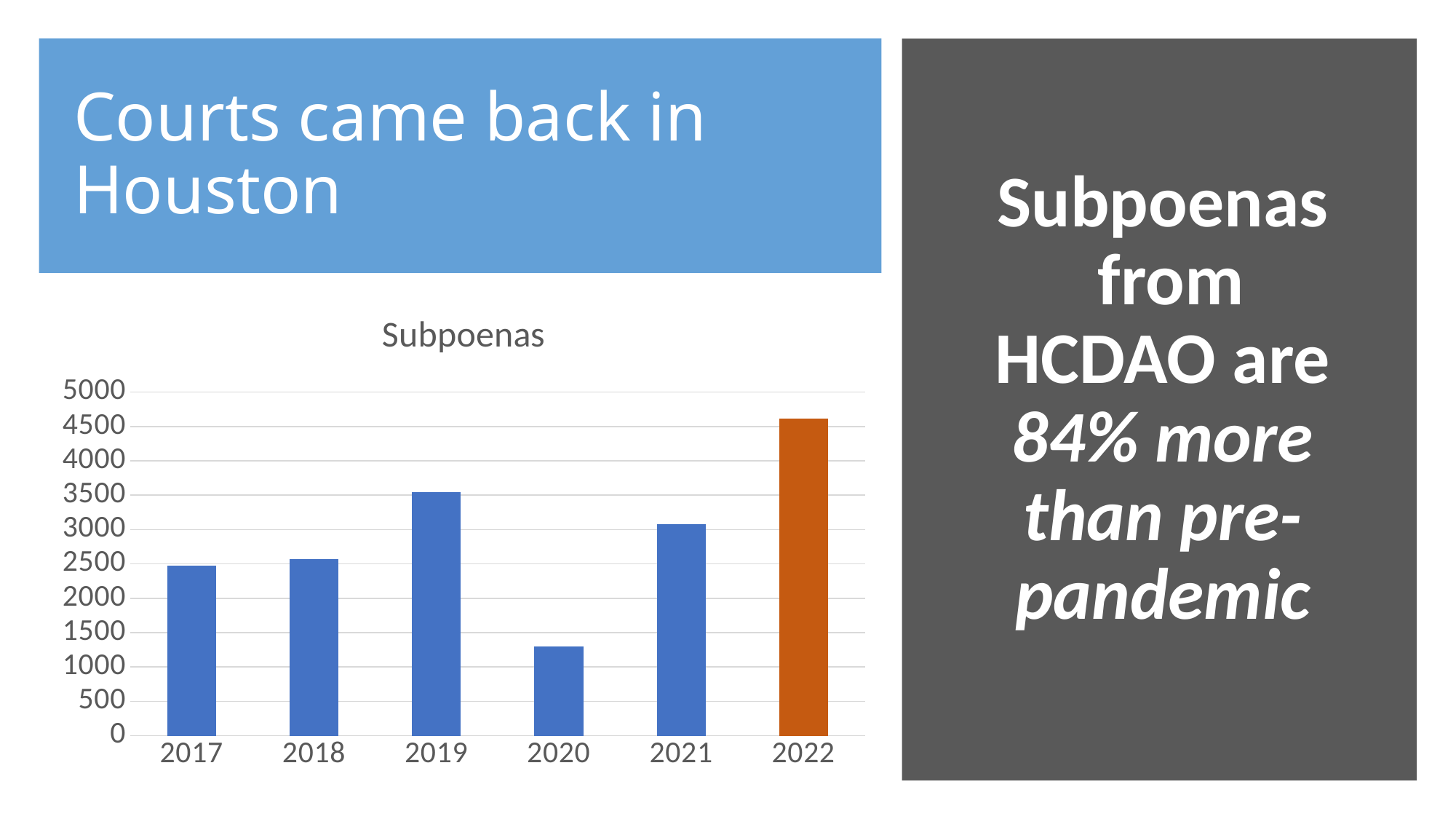
Do the values rise or fall from 2020 to 2022? rise Which year has more subpoenas, 2019 or 2021? 2019 What kind of chart is shown on the slide? bar chart What is the title of the chart? Subpoenas How many years are shown on the x axis of the chart? 6 Which year has the highest number of subpoenas? 2022 Which year has more subpoenas, 2020 or 2017? 2017 Which year's bar is coloured orange instead of blue? 2022 Is the value for 2022 greater or less than 4500? greater Which year has the lowest number of subpoenas? 2020 Is the value for 2020 greater or less than 1500? less Is the value for 2019 greater or less than 3000? greater